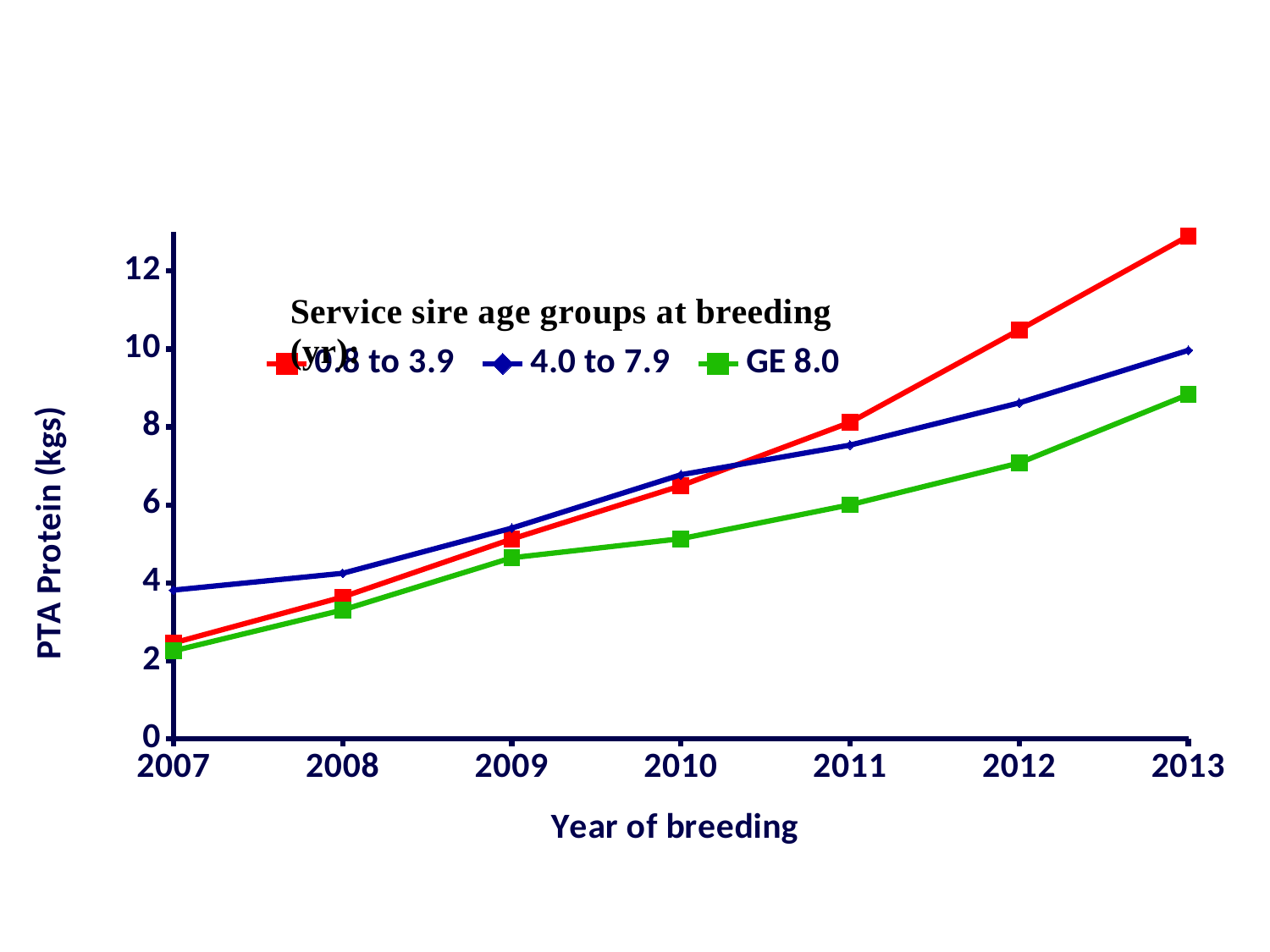
What is the title of the y axis? PTA Protein (kgs) Which series has the highest value in 2013? 0.8 to 3.9 (red line) What kind of chart is shown on the slide? line chart Is the value for GE 8.0 in 2007 greater or less than 4? less In 2007, which is larger: the value for 4.0 to 7.9 or the value for GE 8.0? 4.0 to 7.9 Which series has the lowest value in 2013? GE 8.0 Does the GE 8.0 line rise or fall from 2007 to 2013? rise How many series does the legend list? 3 Is the value for GE 8.0 in 2013 greater or less than 10? less Is the value for 4.0 to 7.9 in 2011 greater or less than 8? less How many years are shown along the x axis? 7